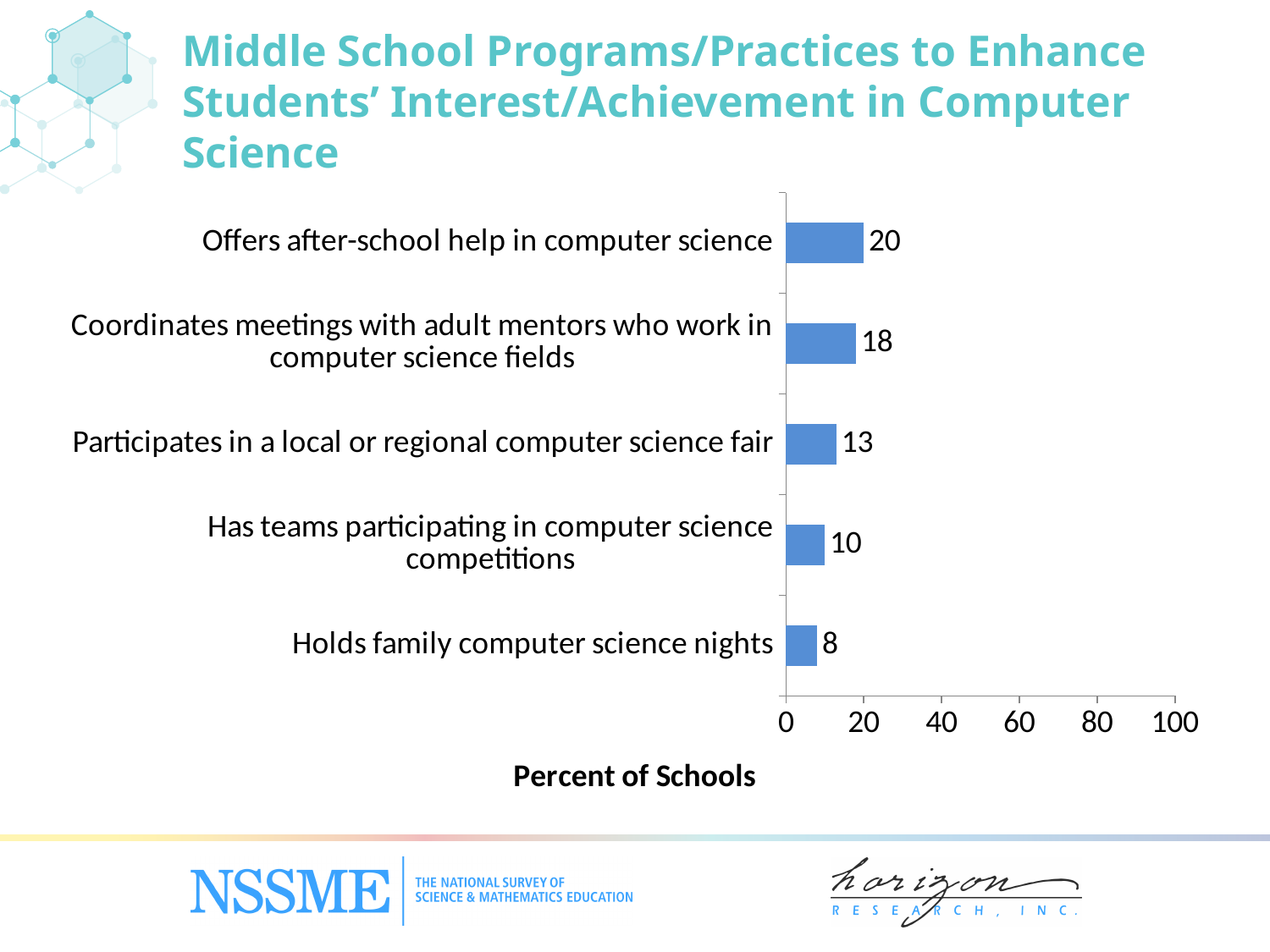
Is the value for 'Coordinates meetings with adult mentors who work in computer science fields' greater or less than 40? less What percent of schools coordinate meetings with adult mentors who work in computer science fields? 18 How many programs/practices are shown in the chart? 5 What is the value for 'Holds family computer science nights'? 8 Which program/practice has the lowest percent of schools? Holds family computer science nights What is the maximum value shown on the horizontal axis? 100 What is the difference between the percent of schools that offer after-school help in computer science and the percent that hold family computer science nights? 12 Which program/practice has the highest percent of schools? Offers after-school help in computer science What percent of schools offer after-school help in computer science? 20 Which is larger: the value for 'Participates in a local or regional computer science fair' or the value for 'Has teams participating in computer science competitions'? Participates in a local or regional computer science fair What is the label of the horizontal axis? Percent of Schools What kind of chart is shown on the slide? Bar chart